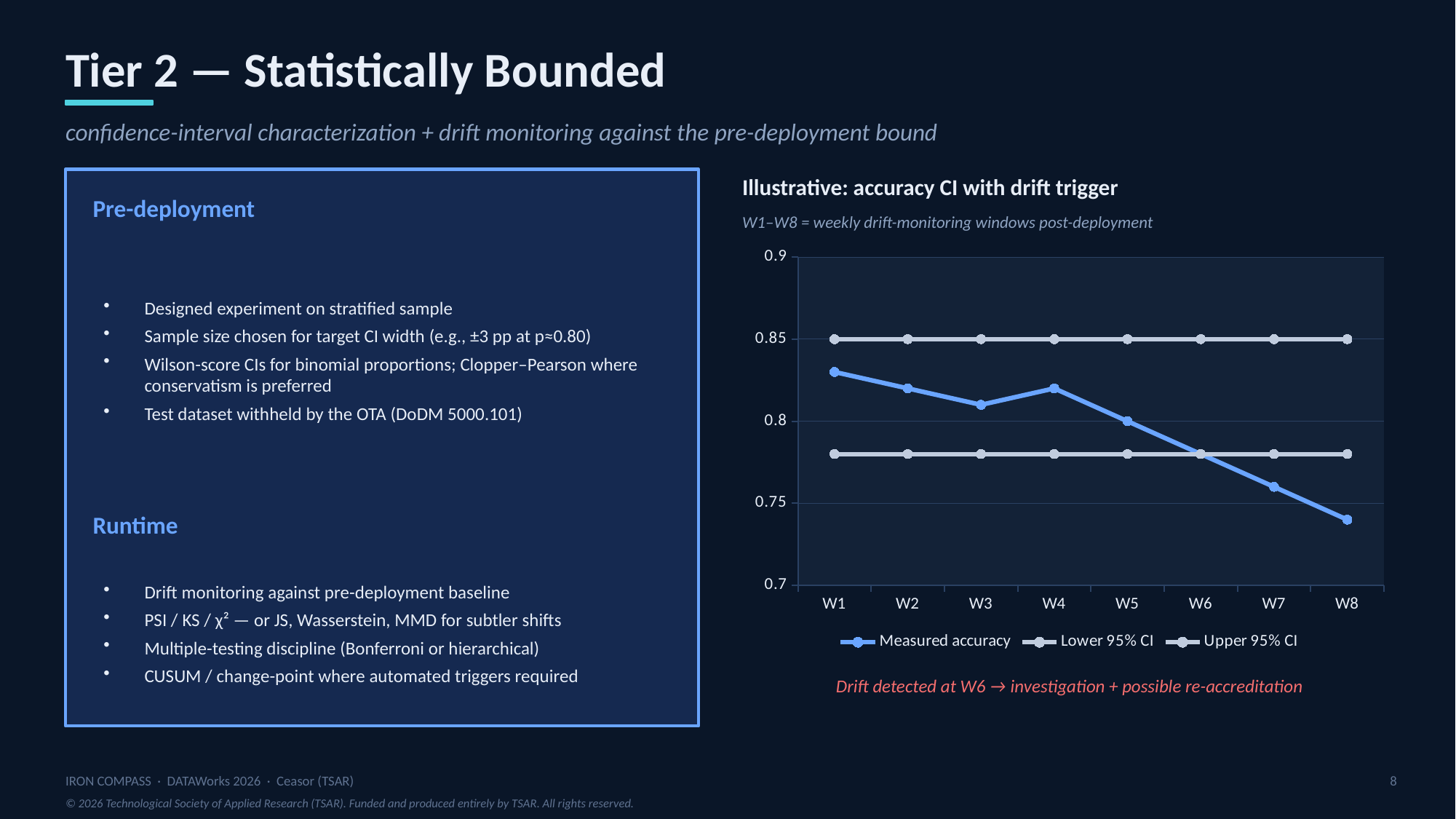
Does Measured accuracy generally rise or fall from W1 to W8? fall What is the title of the chart? Illustrative: accuracy CI with drift trigger Is the Lower 95% CI value greater or less than 0.8? less How many weekly windows are plotted along the x axis? 8 What kind of chart is shown on the slide? line chart How many series does the chart legend list? 3 At which week is Measured accuracy highest? W1 Is the Measured accuracy at W8 greater or less than 0.8? less At which week is Measured accuracy lowest? W8 What is the value of the Upper 95% CI series across the weeks? 0.85 Is the Measured accuracy at W1 greater or less than 0.8? greater Which is larger, Measured accuracy at W2 or at W6? W2